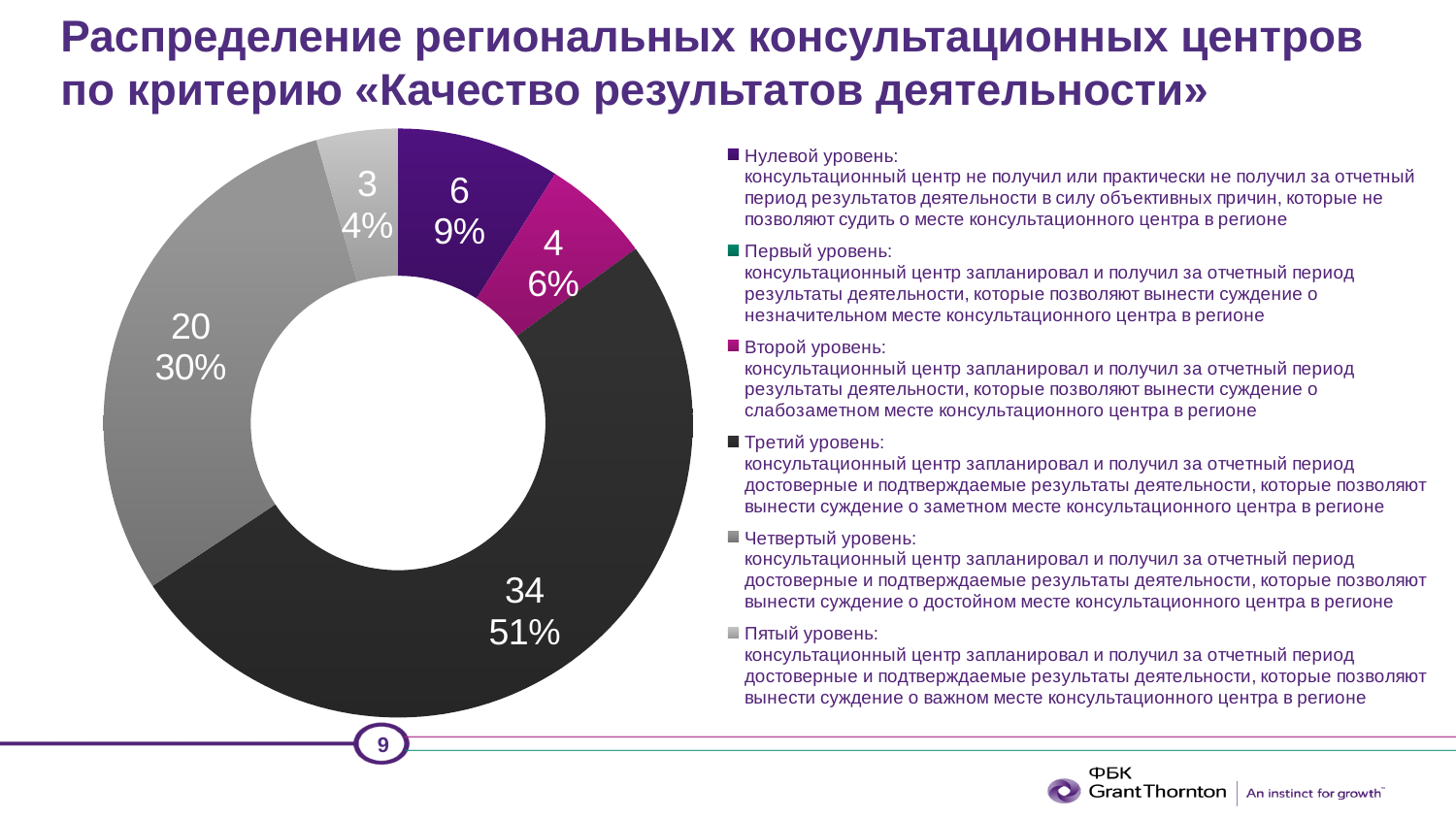
What percentage share does «Нулевой уровень» (the purple segment) have? 9% How many entries does the chart legend list? 6 What is the number of centres for «Третий уровень» (the dark segment)? 34 What percentage share does «Третий уровень» have in the chart? 51% Which level has the largest segment in the chart? Третий уровень What kind of chart is shown on the slide? Pie (donut) chart How many segments are visible in the donut chart? 5 What is the percentage share of the light grey segment labelled 3? 4% Which is larger: the segment for «Нулевой уровень» or the segment for «Второй уровень»? Нулевой уровень Which visible segment is the smallest in the chart? Пятый уровень What is the difference in the number of centres between «Третий уровень» and «Четвертый уровень»? 14 What is the number of centres for «Четвертый уровень» (the grey segment)? 20